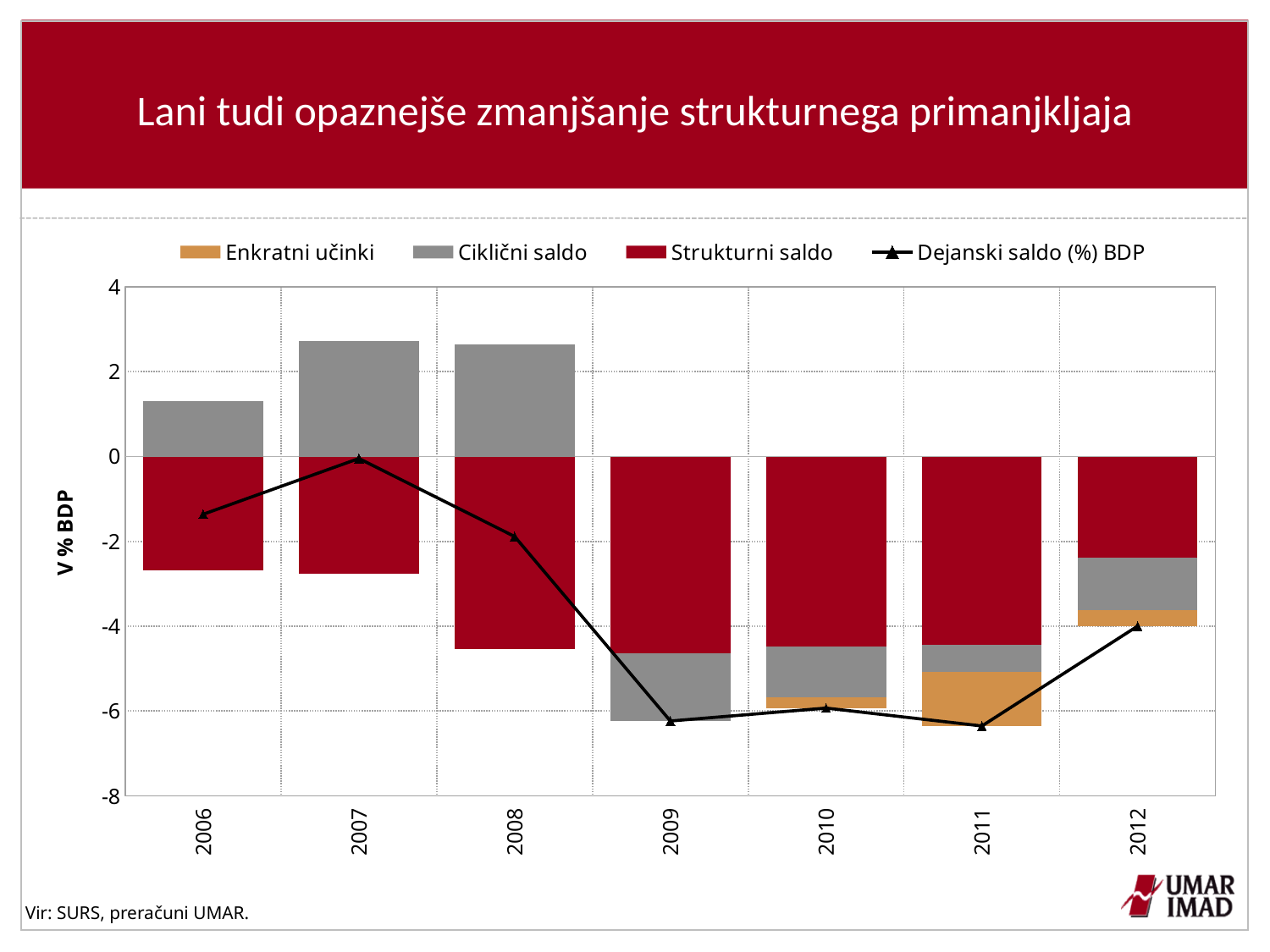
How many years are shown on the x axis of the chart? 7 How many series does the chart legend list? 4 What is the label of the vertical axis? V % BDP In which year is the Dejanski saldo (%) BDP line at its highest? 2007 Is the Ciklični saldo value for 2007 greater or less than 2? greater Which series is plotted as a line with triangle markers? Dejanski saldo (%) BDP What kind of chart is shown on the slide? A stacked bar chart combined with a line Is the Strukturni saldo value for 2006 greater or less than -2? less Which is larger, the Dejanski saldo (%) BDP value for 2007 or for 2009? 2007 Is the Strukturni saldo value for 2009 greater or less than -4? less In which year is the Enkratni učinki segment the largest? 2011